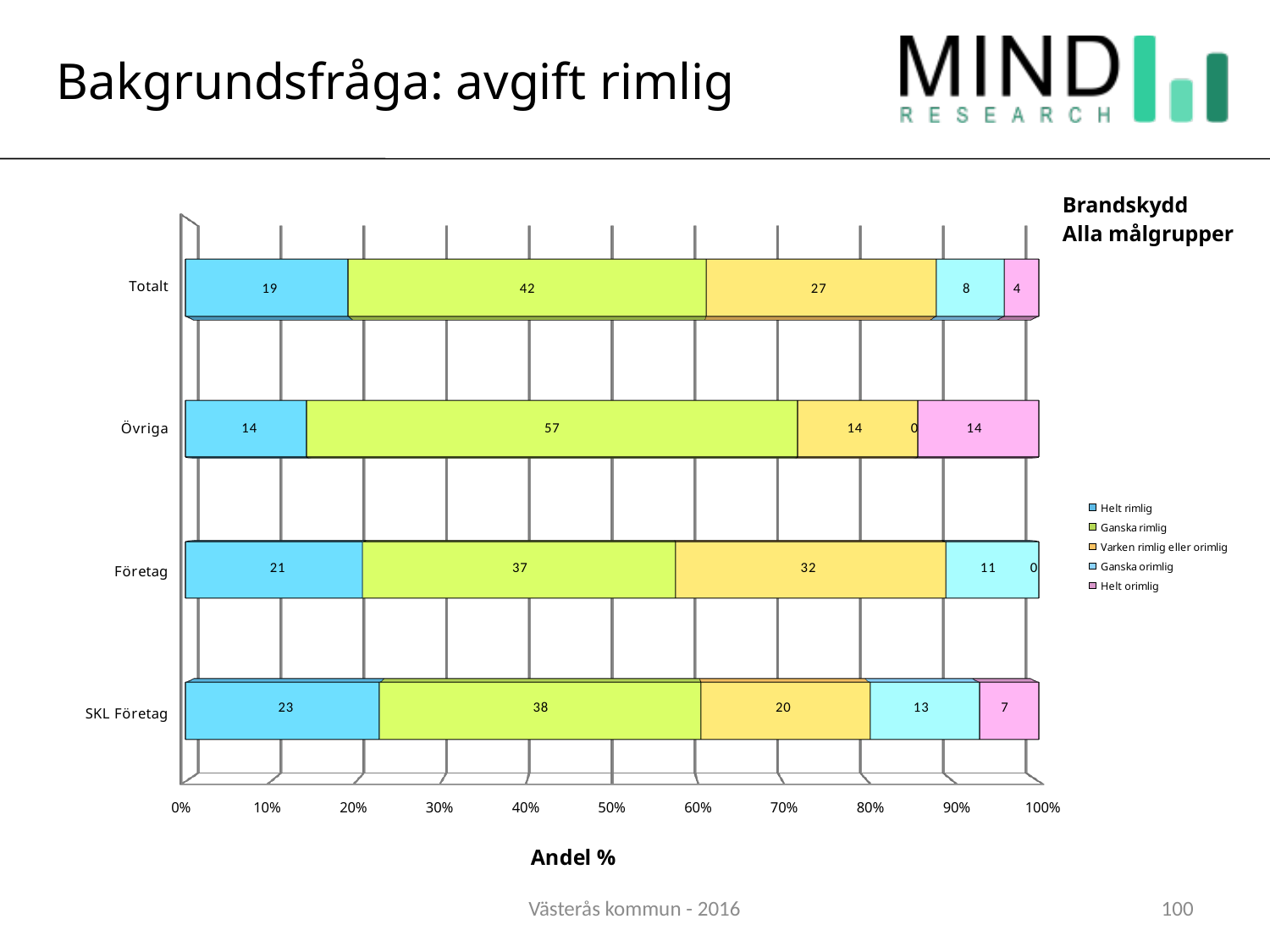
What is the value of Varken rimlig eller orimlig for Företag? 32 What kind of chart is shown on the slide? Stacked bar chart How many series does the legend list? 5 Which category has the highest value for Helt rimlig? SKL Företag What is the label of the horizontal axis? Andel % How many categories are shown on the vertical axis? 4 Which is larger: Helt rimlig for Företag or Helt rimlig for Övriga? Företag What is the value of Helt orimlig for SKL Företag? 7 What is the value of Ganska rimlig for Övriga? 57 What is the value of Ganska orimlig for Totalt? 8 Which category has the lowest value for Ganska rimlig? Företag What is the difference between the Ganska rimlig values for Övriga and Totalt? 15